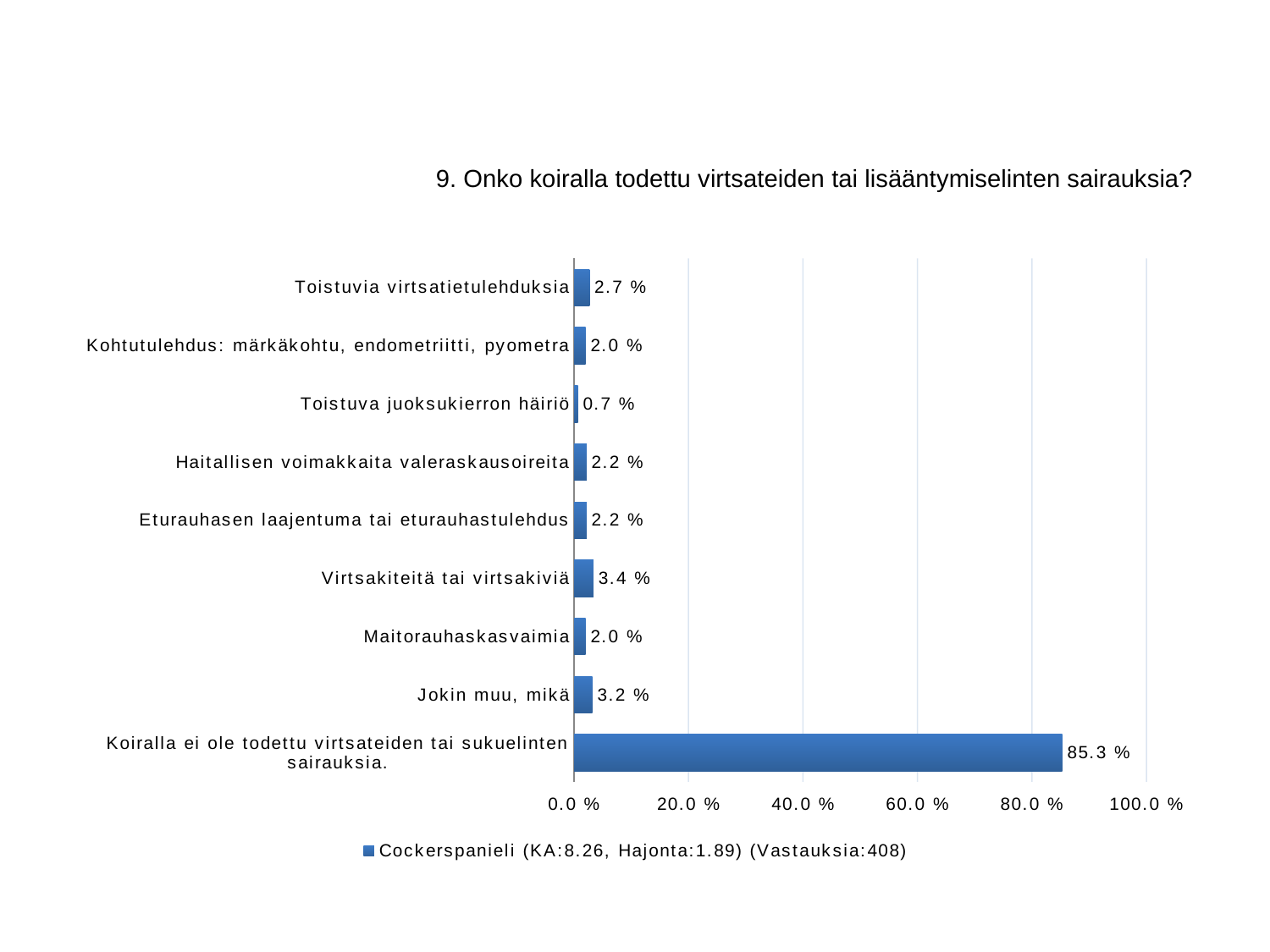
How many categories are shown in the chart? 9 What is the value for "Koiralla ei ole todettu virtsateiden tai sukuelinten sairauksia."? 85.3 % What is the value for "Virtsakiteitä tai virtsakiviä"? 3.4 % Is the value for "Koiralla ei ole todettu virtsateiden tai sukuelinten sairauksia." greater or less than 80.0 %? greater Which category has the lowest value? Toistuva juoksukierron häiriö What kind of chart is shown on the slide? bar chart Which is larger, the value for "Toistuvia virtsatietulehduksia" or the value for "Maitorauhaskasvaimia"? Toistuvia virtsatietulehduksia What is the legend entry of the chart? Cockerspanieli (KA:8.26, Hajonta:1.89) (Vastauksia:408) Which category has the highest value? Koiralla ei ole todettu virtsateiden tai sukuelinten sairauksia. What is the value for "Toistuvia virtsatietulehduksia"? 2.7 % What is the value for "Toistuva juoksukierron häiriö"? 0.7 % What is the difference between the values for "Virtsakiteitä tai virtsakiviä" and "Jokin muu, mikä"? 0.2 %